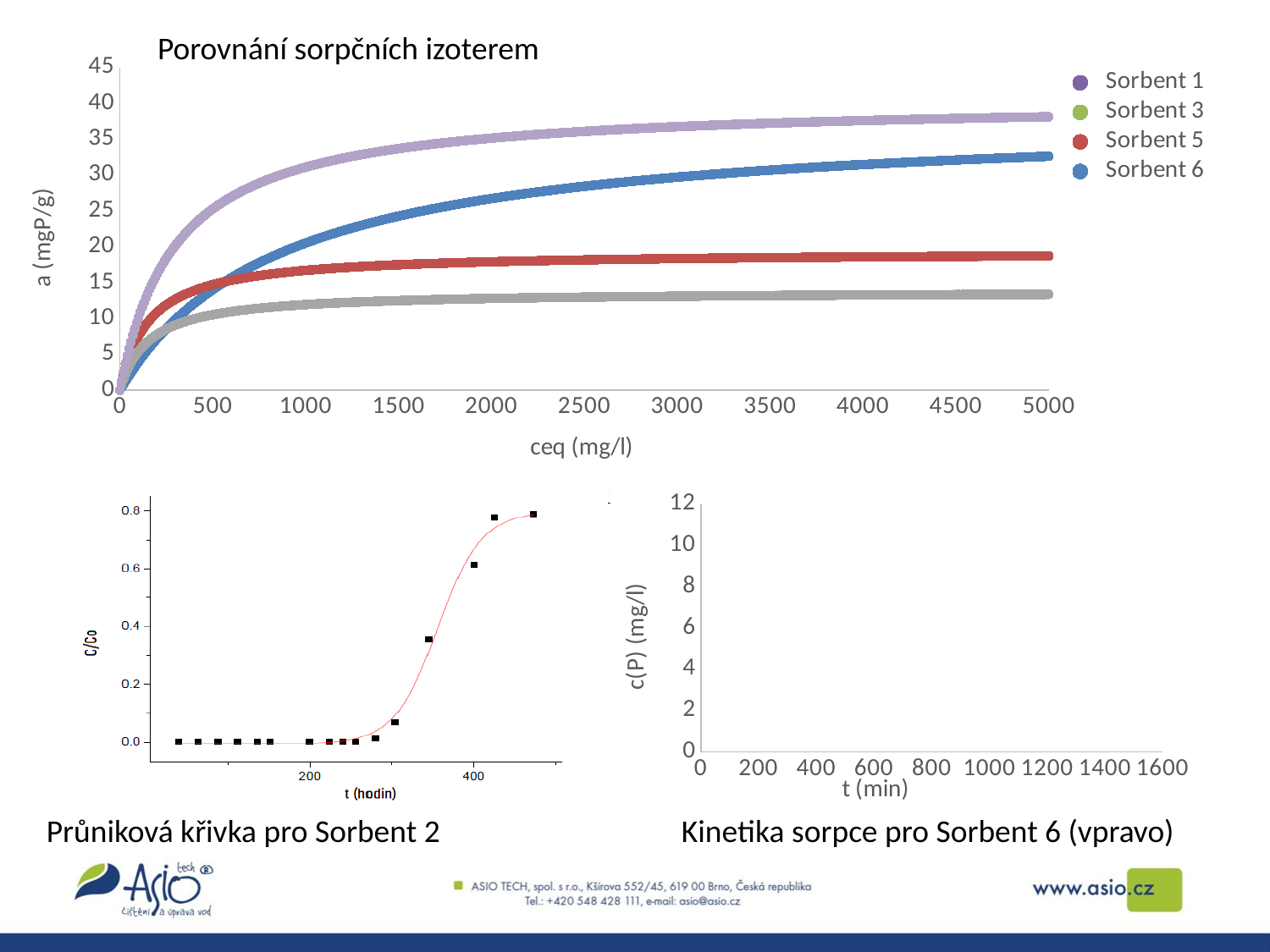
In the chart titled 'Porovnání sorpčních izoterem', is the value for Sorbent 1 at ceq = 5000 mg/l greater or less than 35? greater In the chart titled 'Porovnání sorpčních izoterem', is the value for Sorbent 5 at ceq = 5000 mg/l greater or less than 20? less In the chart titled 'Porovnání sorpčních izoterem', what is the label of the y axis? a (mgP/g) In the chart titled 'Porovnání sorpčních izoterem', which is larger at ceq = 5000 mg/l, Sorbent 1 or Sorbent 6? Sorbent 1 In the chart titled 'Porovnání sorpčních izoterem', which series has the highest value at ceq = 5000 mg/l? Sorbent 1 In the chart titled 'Porovnání sorpčních izoterem', do the values for Sorbent 6 rise or fall as ceq increases? rise In the bottom-right chart (Kinetika sorpce pro Sorbent 6), what is the highest value shown on the y axis? 12 In the bottom-left chart (Průniková křivka pro Sorbent 2), what is the label of the x axis? t (hodin) In the chart titled 'Porovnání sorpčních izoterem', what kind of chart is it? line chart In the chart titled 'Porovnání sorpčních izoterem', is the value for Sorbent 6 at ceq = 5000 mg/l greater or less than 30? greater In the chart titled 'Porovnání sorpčních izoterem', how many series does the legend list? 4 In the bottom-left chart (Průniková křivka pro Sorbent 2), do the C/Co values rise or fall as t increases? rise